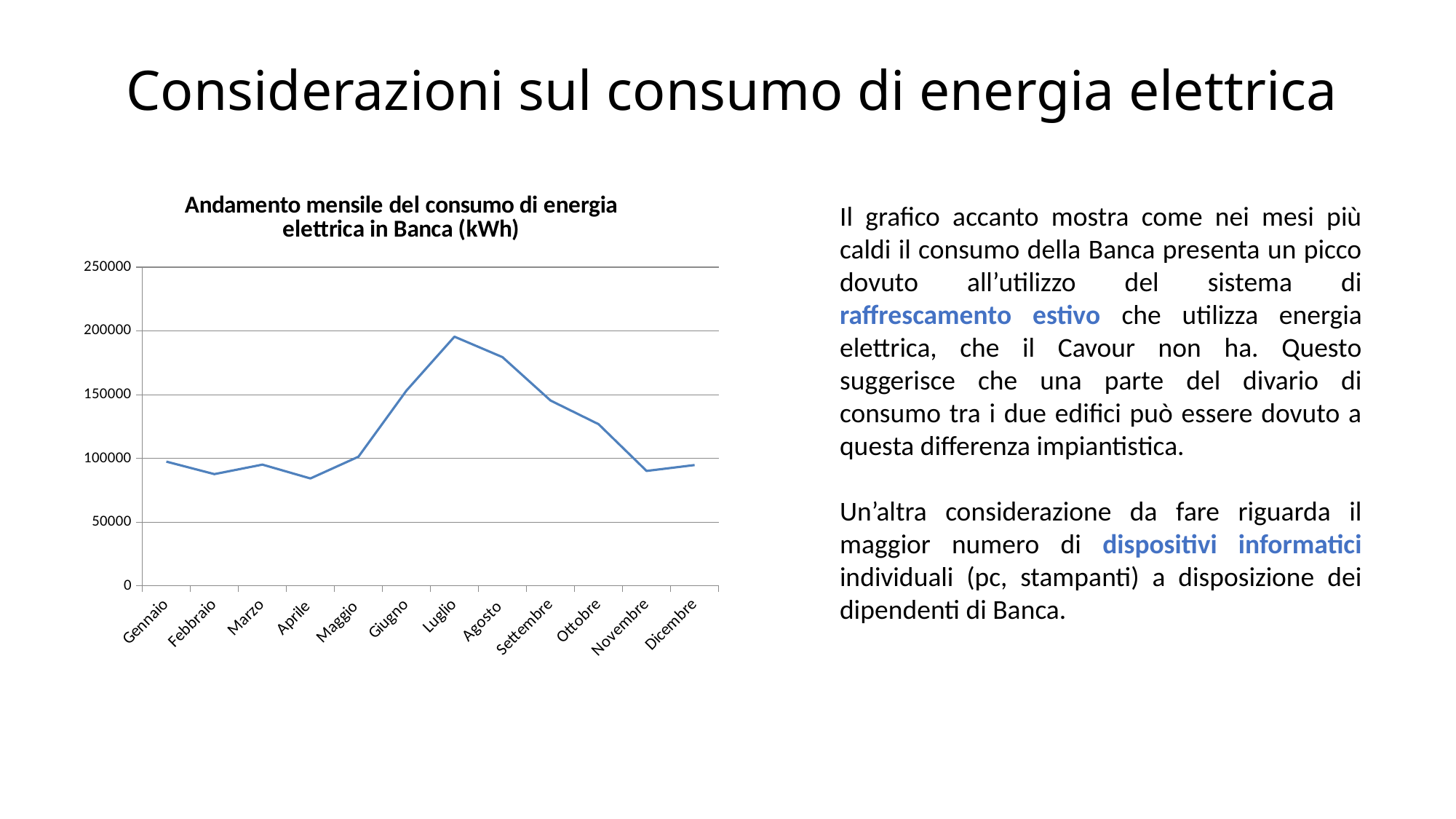
What kind of chart is shown on the slide? line chart Is the value for Luglio greater or less than 150000? greater Which month has the higher consumption, Gennaio or Giugno? Giugno Which month has the higher consumption, Luglio or Agosto? Luglio Is the value for Aprile greater or less than 100000? less Does the consumption rise or fall from Luglio to Novembre? fall Is the value for Ottobre greater or less than 100000? greater How many months are plotted on the x axis of the chart? 12 What is the title of the chart? Andamento mensile del consumo di energia elettrica in Banca (kWh) Which month has the lowest energy consumption in the chart? Aprile Which month has the highest energy consumption in the chart? Luglio